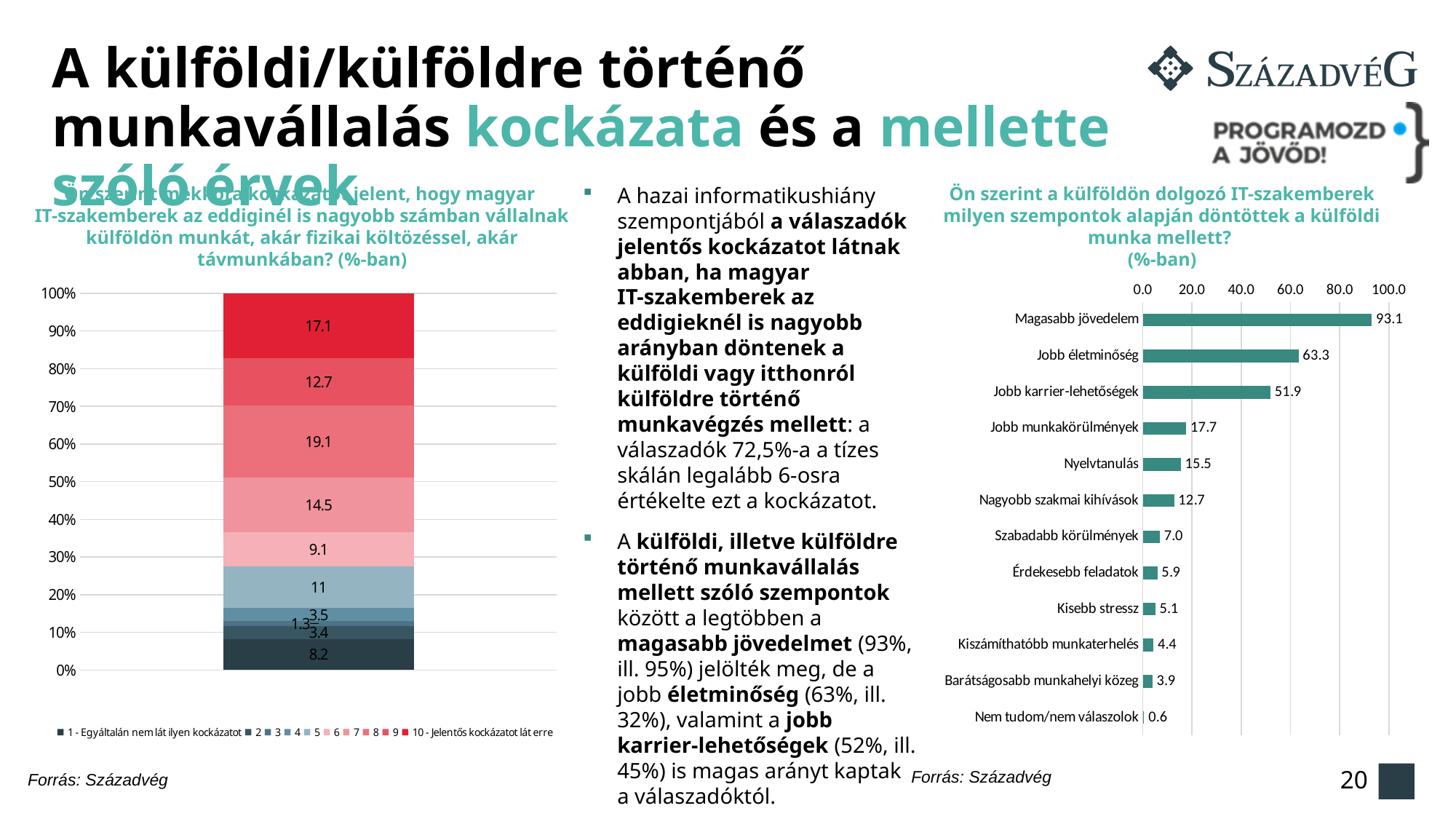
In the right-hand chart, which category has the lowest value? Nem tudom/nem válaszolok In the left-hand stacked bar chart, which series has the largest segment? 8 In the right-hand chart, what is the value for "Nyelvtanulás"? 15.5 In the left-hand stacked bar chart, what is the value of the segment for series "10 - Jelentős kockázatot lát erre"? 17.1 In the right-hand chart, which is larger: the value for "Jobb munkakörülmények" or the value for "Nagyobb szakmai kihívások"? Jobb munkakörülmények In the left-hand stacked bar chart, what is the value of the segment for series "1 - Egyáltalán nem lát ilyen kockázatot"? 8.2 In the right-hand chart, what is the difference between the values for "Jobb életminőség" and "Jobb karrier-lehetőségek"? 11.4 How many series does the legend of the left-hand stacked bar chart list? 10 In the right-hand chart, what is the value for "Magasabb jövedelem"? 93.1 How many categories are shown in the right-hand chart? 12 What kind of chart is the right-hand chart? Bar chart In the right-hand chart, which category has the highest value? Magasabb jövedelem